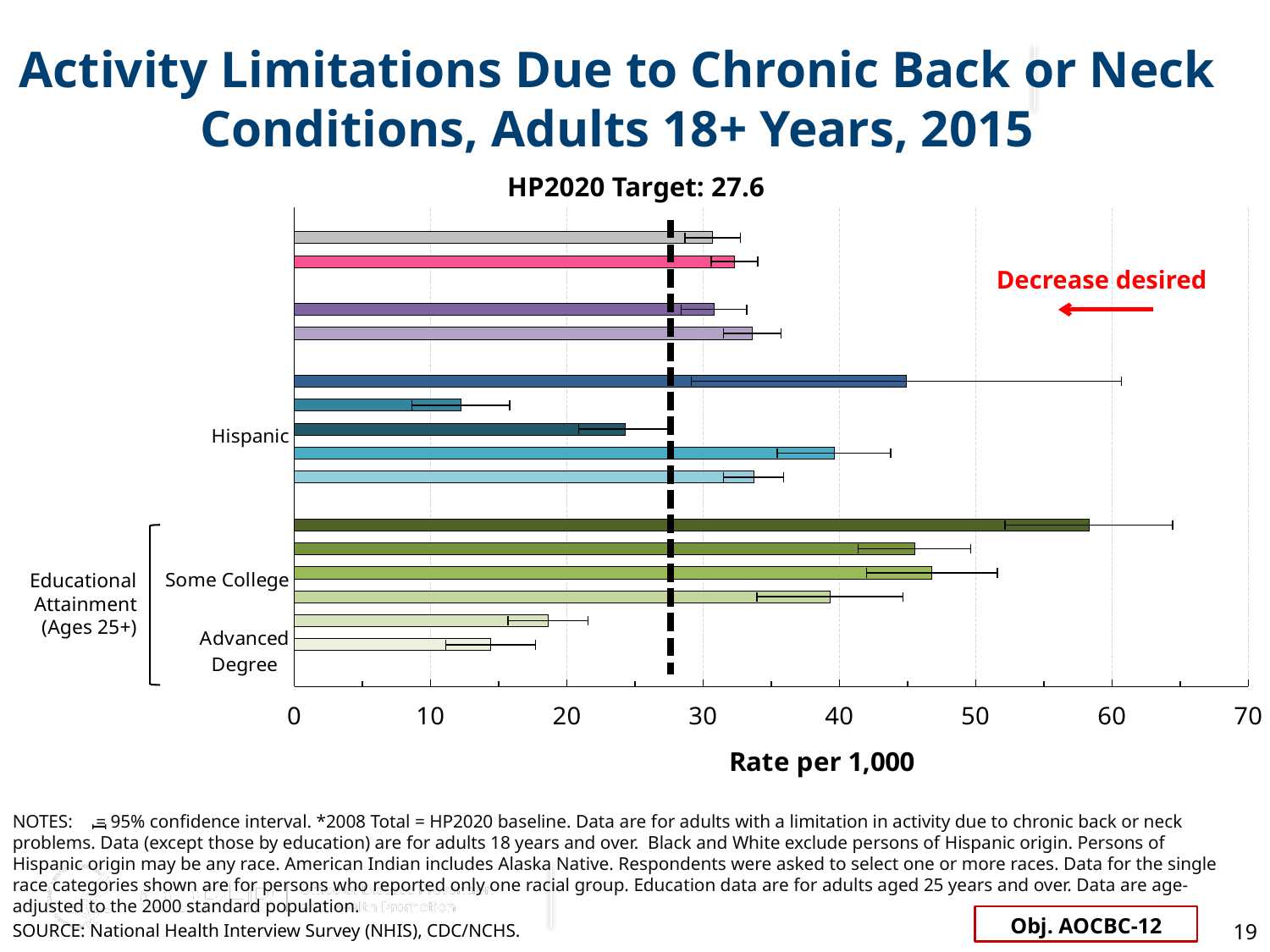
What is the label of the x axis? Rate per 1,000 Is the value for Hispanic greater or less than 30? less Is the value for Some College greater or less than 50? less Which is larger, the value for Some College or the value for Hispanic? Some College Is the value for Advanced Degree greater or less than 20? less Of the labeled categories Hispanic, Some College and Advanced Degree, which has the lowest value? Advanced Degree Which is larger, the value for Hispanic or the value for Advanced Degree? Hispanic What is the HP2020 Target value shown above the chart? 27.6 What kind of chart is shown on the slide? bar chart